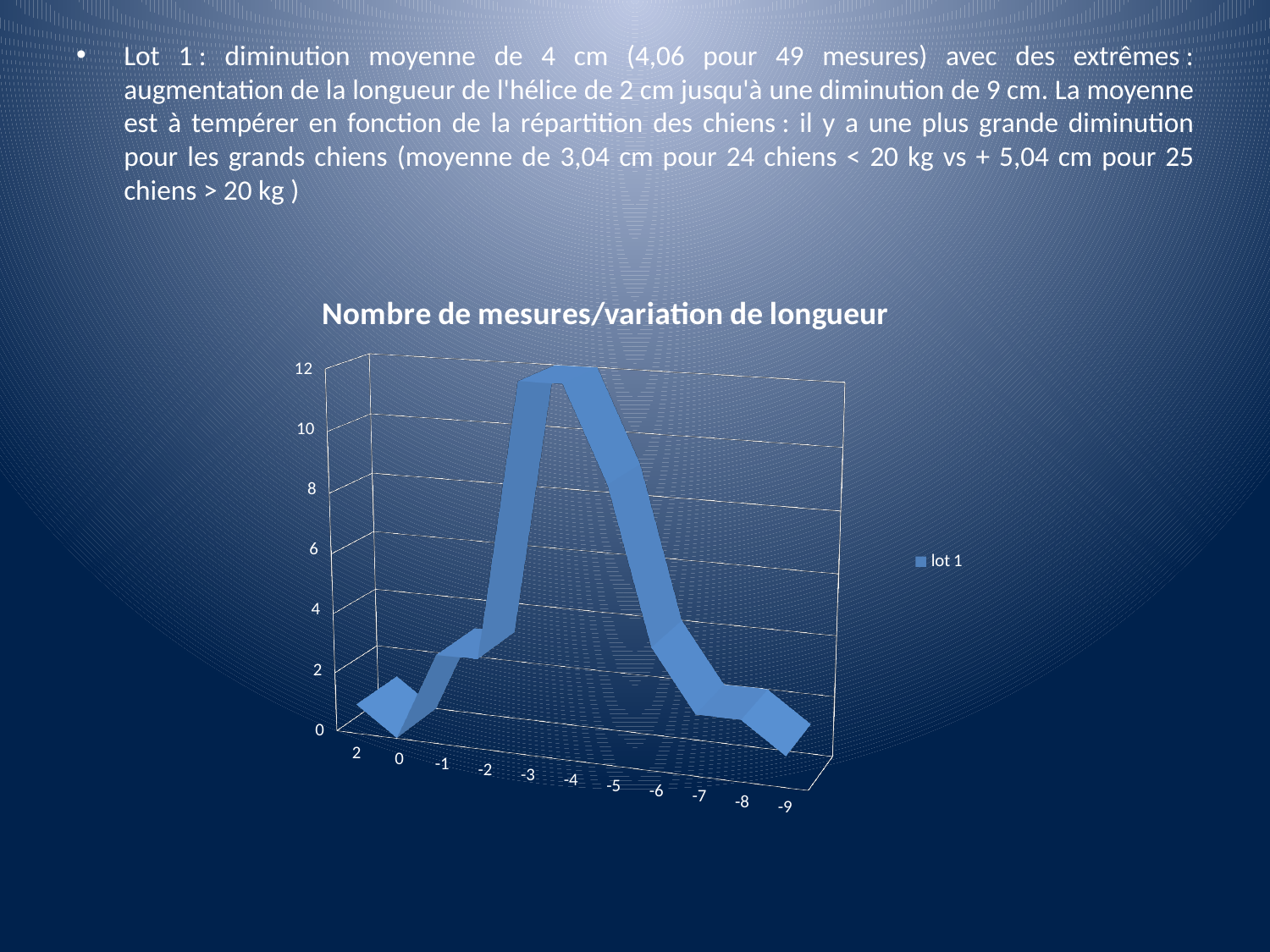
Is the value for -3 greater or less than 10? greater Is the value for -9 greater or less than 2? less Which has the larger value, -3 or -9? -3 How many series does the legend list? 1 What is the name of the series shown in the legend? lot 1 Is the value for -7 greater or less than 4? less How many categories are shown on the x axis? 11 What is the title of the chart? Nombre de mesures/variation de longueur What kind of chart is shown on the slide? line chart